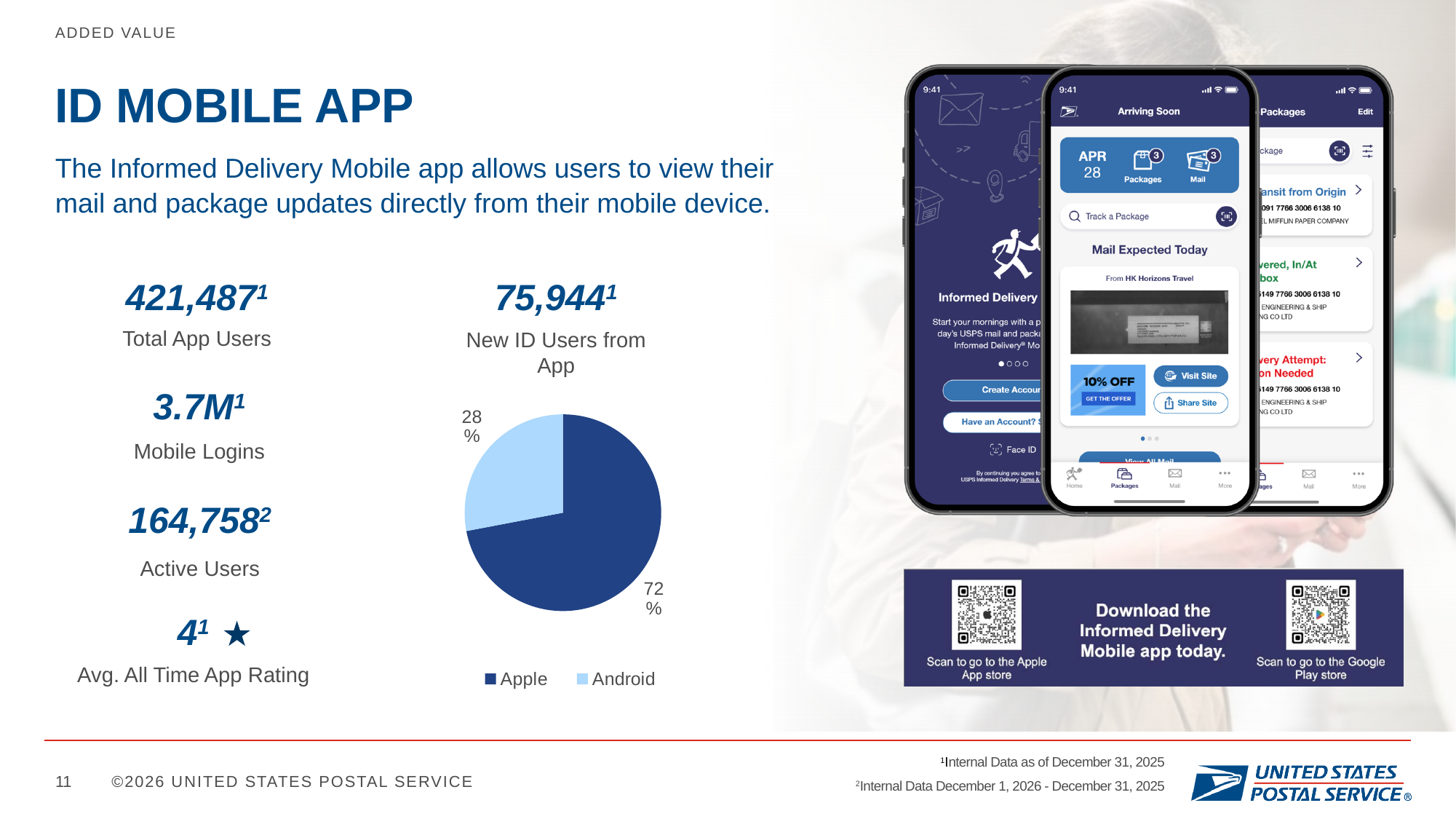
What kind of chart is shown on the slide? pie chart How many entries does the pie chart legend list? 2 Is the Android share of the pie chart greater or less than 50%? less Which slice of the pie chart is the largest? Apple What share of the pie chart is Apple? 72% Which legend entry is shown in light blue in the pie chart? Android Which slice of the pie chart is the smallest? Android What is the difference in percentage points between the Apple and Android slices? 44 How many slices does the pie chart have? 2 What share of the pie chart is Android? 28% Which is larger in the pie chart, Apple or Android? Apple Which legend entry is shown in dark blue in the pie chart? Apple